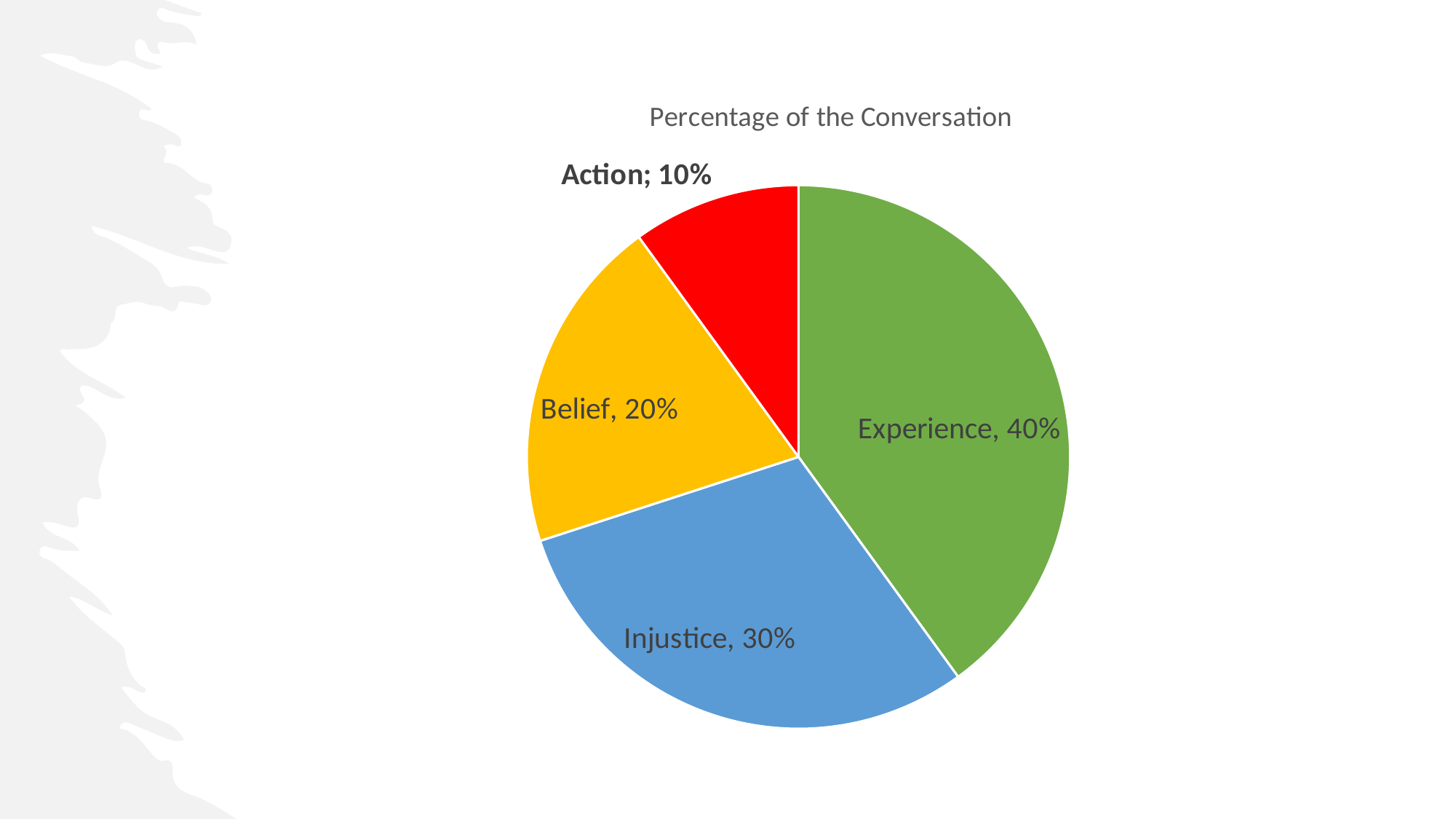
What percentage of the conversation is Belief? 20% What is the difference between the Experience and Injustice shares? 10% What percentage of the conversation is Injustice? 30% Which category has the largest share of the conversation? Experience What colour is the Experience slice? Green Which is larger, the Belief share or the Injustice share? Injustice How many slices does the pie chart have? 4 Which category has the smallest share of the conversation? Action What percentage of the conversation is Action? 10% What kind of chart is shown on the slide? Pie chart What percentage of the conversation is Experience? 40% What is the title of the chart? Percentage of the Conversation